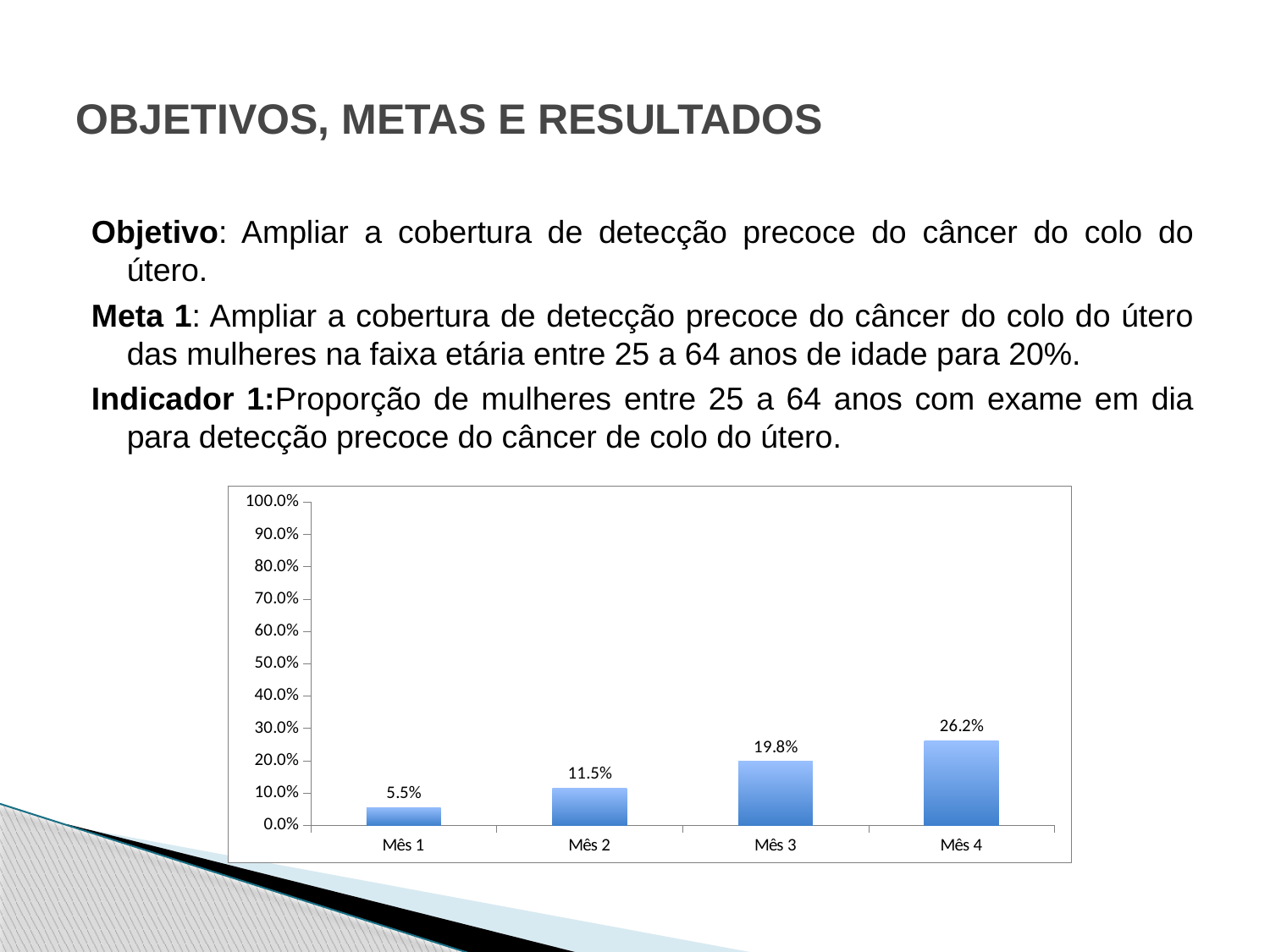
What is the difference between the values for Mês 4 and Mês 1? 20.7% What is the difference between the values for Mês 2 and Mês 1? 6.0% Which is larger, the value for Mês 2 or the value for Mês 3? Mês 3 What is the value for Mês 4? 26.2% Do the values rise or fall from Mês 1 to Mês 4? rise What kind of chart is shown on the slide? bar chart Which month has the highest value? Mês 4 What is the value for Mês 3? 19.8% Is the value for Mês 4 greater or less than 20.0%? greater Which month has the lowest value? Mês 1 What is the value for Mês 1? 5.5% How many months are shown on the x axis? 4